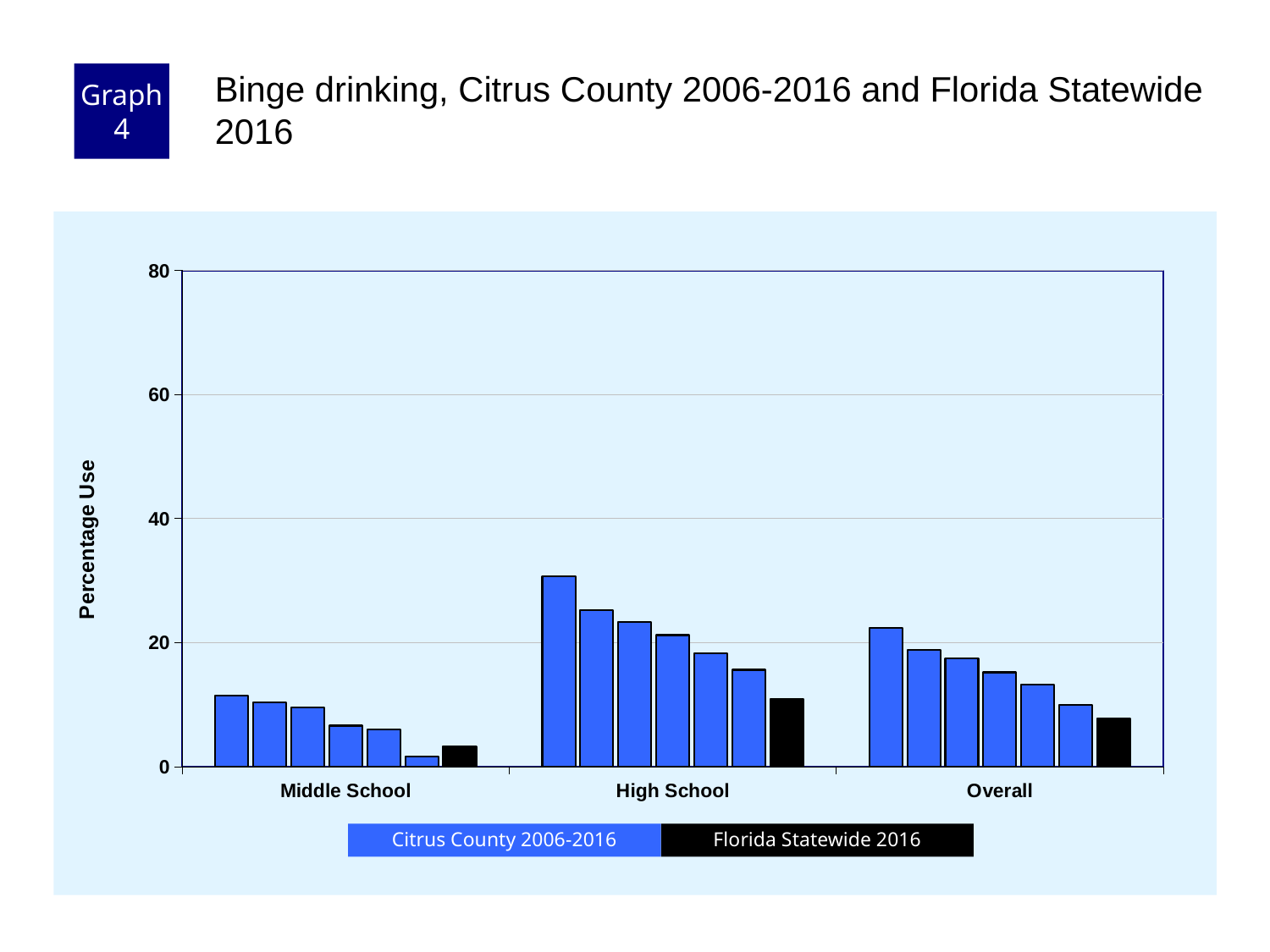
Is the Florida Statewide 2016 value for Middle School greater or less than 20? less Which is larger, the Florida Statewide 2016 value for High School or for Middle School? High School How many series does the chart legend list? 2 Is the Florida Statewide 2016 value for High School greater or less than 20? less What is the label on the y axis of the chart? Percentage Use What kind of chart is shown on the slide? bar chart Which category has the highest bars in the chart? High School Within the High School category, do the Citrus County 2006-2016 bars rise or fall from left to right? fall How many categories are shown on the x axis of the chart? 3 Which category has the lowest bars in the chart? Middle School Is the tallest Citrus County 2006-2016 bar for High School greater or less than 20? greater What colour are the Florida Statewide 2016 bars in the chart? black